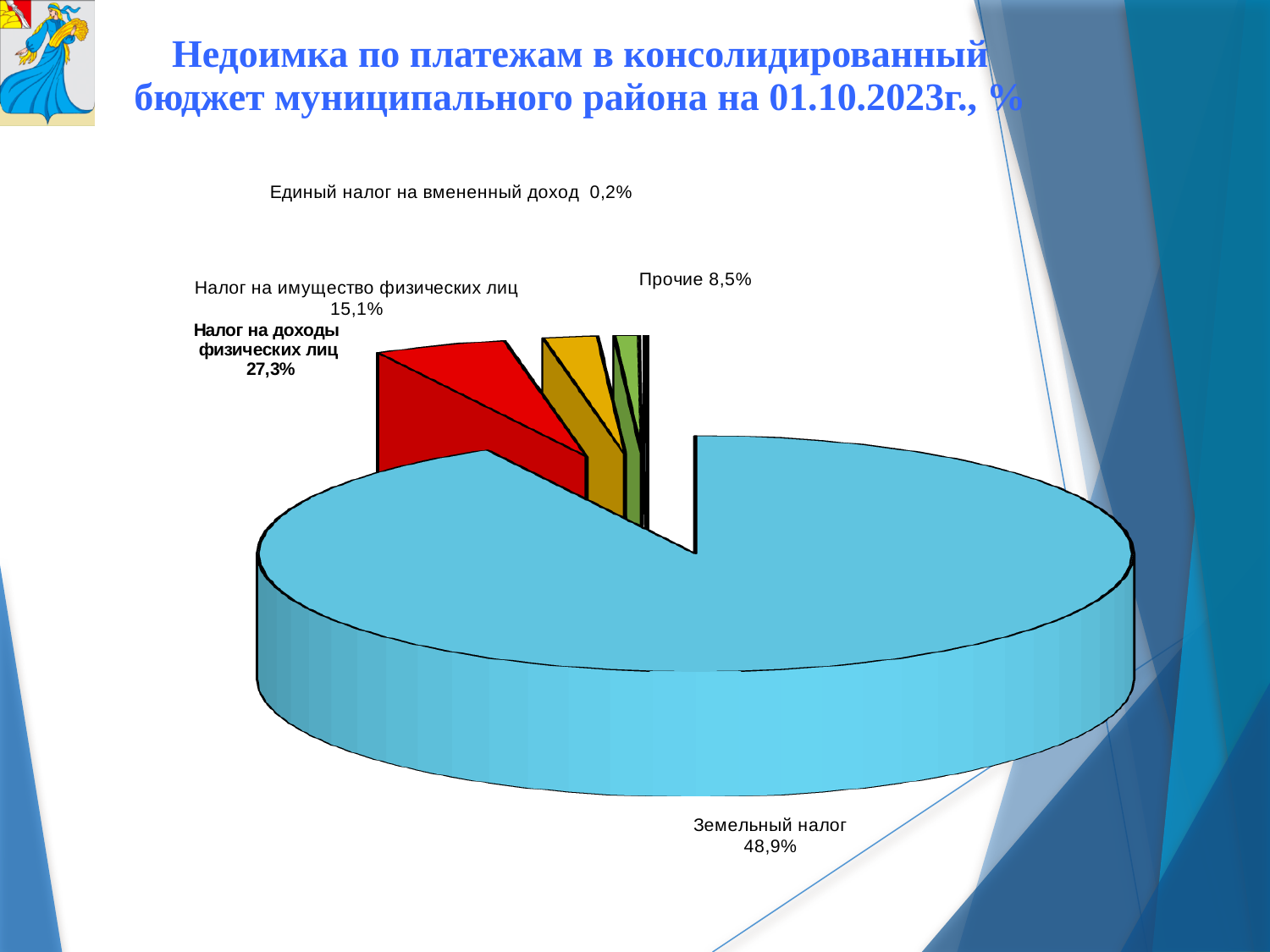
What colour is the slice for Налог на доходы физических лиц? Red What is the value shown for Налог на доходы физических лиц? 27,3% What is the value shown for Налог на имущество физических лиц? 15,1% What kind of chart is shown on the slide? Pie chart What share does Земельный налог have in the pie chart? 48,9% What is the value shown for Прочие? 8,5% Which is larger: Налог на имущество физических лиц or Прочие? Налог на имущество физических лиц Which category has the largest share of the pie? Земельный налог What is the difference in percentage points between Земельный налог and Налог на доходы физических лиц? 21,6 What is the value shown for Единый налог на вмененный доход? 0,2% Which category has the smallest share of the pie? Единый налог на вмененный доход How many slices does the pie chart have? 5